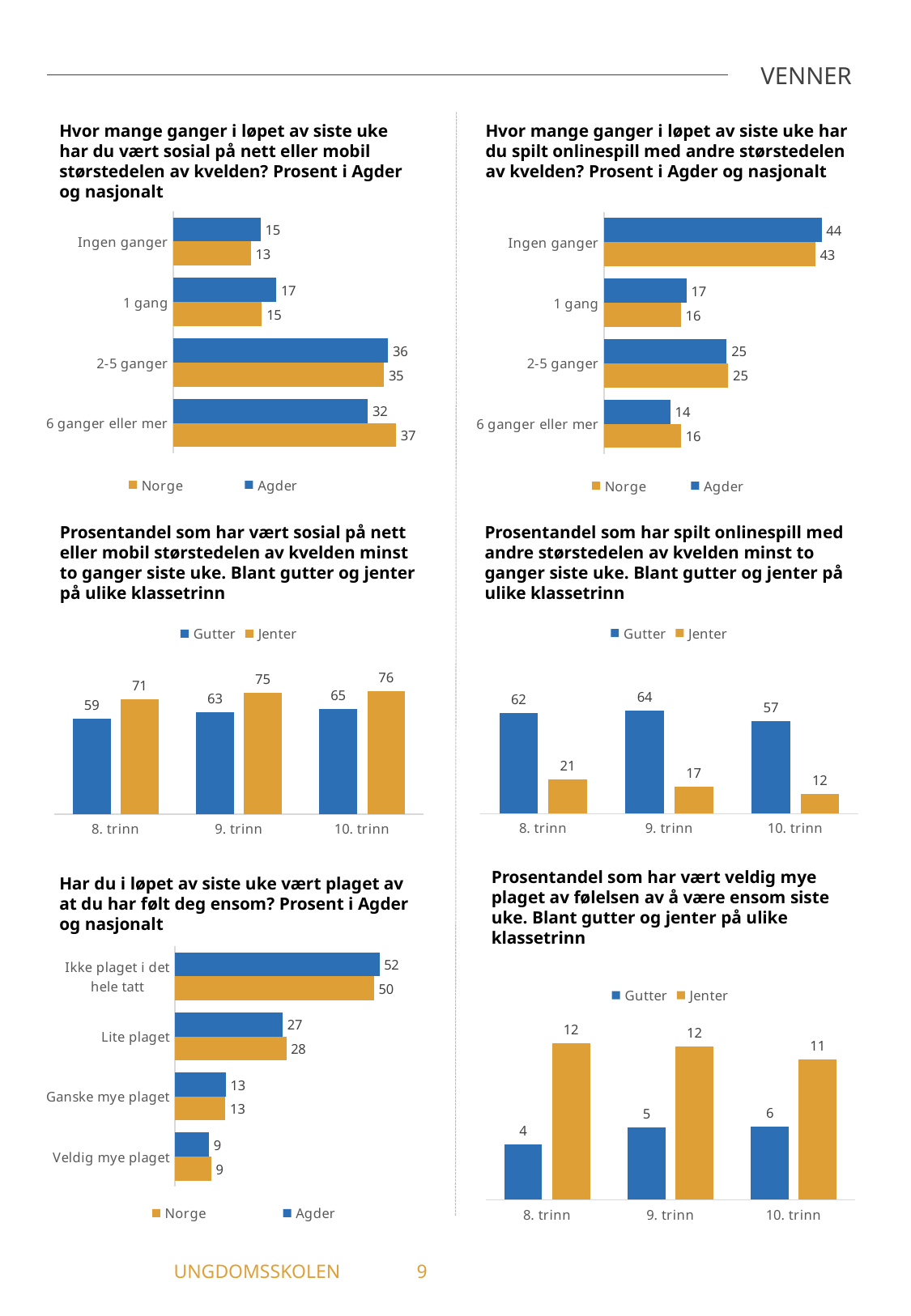
In the top-right chart (spilt onlinespill, Agder og nasjonalt), which category has the lowest value for Agder? 6 ganger eller mer In the top-left chart (sosial på nett eller mobil, Agder og nasjonalt), what is the value for Norge in the '6 ganger eller mer' category? 37 In the top-right chart (spilt onlinespill, Agder og nasjonalt), what is the value for Agder in the 'Ingen ganger' category? 44 In the bottom-right chart (veldig mye plaget av ensomhet, gutter og jenter), what is the value for Gutter at 8. trinn? 4 In the middle-left chart (sosial på nett minst to ganger, gutter og jenter), do the values for Gutter rise or fall from 8. trinn to 10. trinn? rise In the bottom-left chart (plaget av å ha følt deg ensom, Agder og nasjonalt), what is the value for Agder in the 'Lite plaget' category? 27 In the middle-right chart (spilt onlinespill minst to ganger, gutter og jenter), which group has the larger value at 8. trinn, Gutter or Jenter? Gutter How many categories are shown in the bottom-left chart (plaget av å ha følt deg ensom, Agder og nasjonalt)? 4 In the middle-right chart (spilt onlinespill minst to ganger, gutter og jenter), what is the difference between Gutter and Jenter at 9. trinn? 47 In the top-right chart (spilt onlinespill, Agder og nasjonalt), what is the difference between Agder and Norge in the '6 ganger eller mer' category? 2 In the middle-left chart (sosial på nett minst to ganger, gutter og jenter), what is the value for Jenter at 10. trinn? 76 In the top-left chart (sosial på nett eller mobil, Agder og nasjonalt), which category has the highest value for Agder? 2-5 ganger